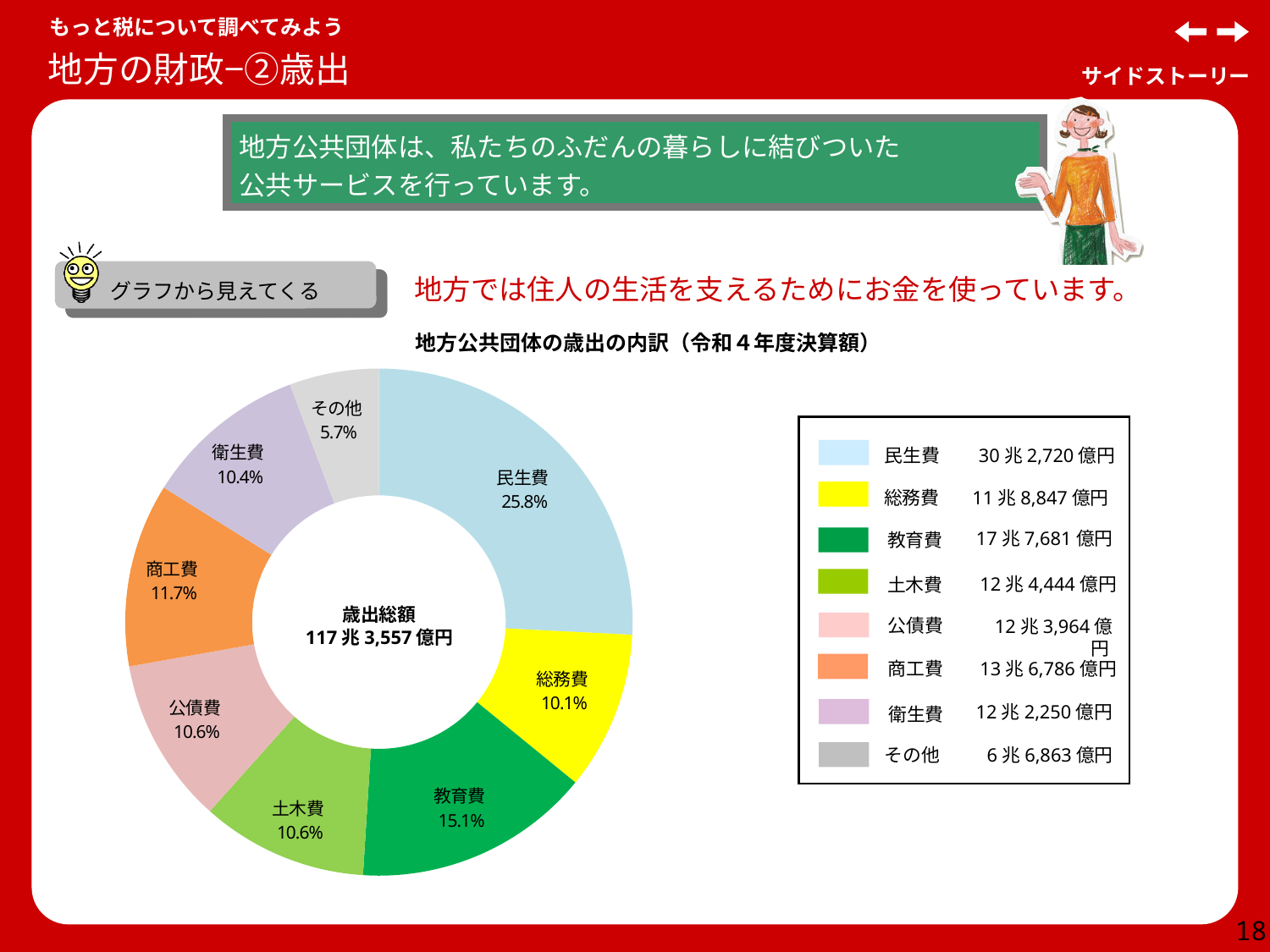
What percentage share does 商工費 have in the chart? 11.7% What is the total expenditure (歳出総額) shown in the centre of the chart? 117兆3,557億円 What type of chart is shown on the slide? Donut (pie) chart What percentage share does 民生費 have in the chart? 25.8% What percentage share does 教育費 have in the chart? 15.1% What is the title of the chart? 地方公共団体の歳出の内訳（令和４年度決算額） How many categories are shown in the chart? 8 According to the legend, what is the amount for 教育費? 17兆7,681億円 Which category has the smallest share of the chart? その他 According to the legend, what is the amount for 衛生費? 12兆2,250億円 Which category has the largest share of the chart? 民生費 Which has a larger share, 商工費 or 総務費? 商工費